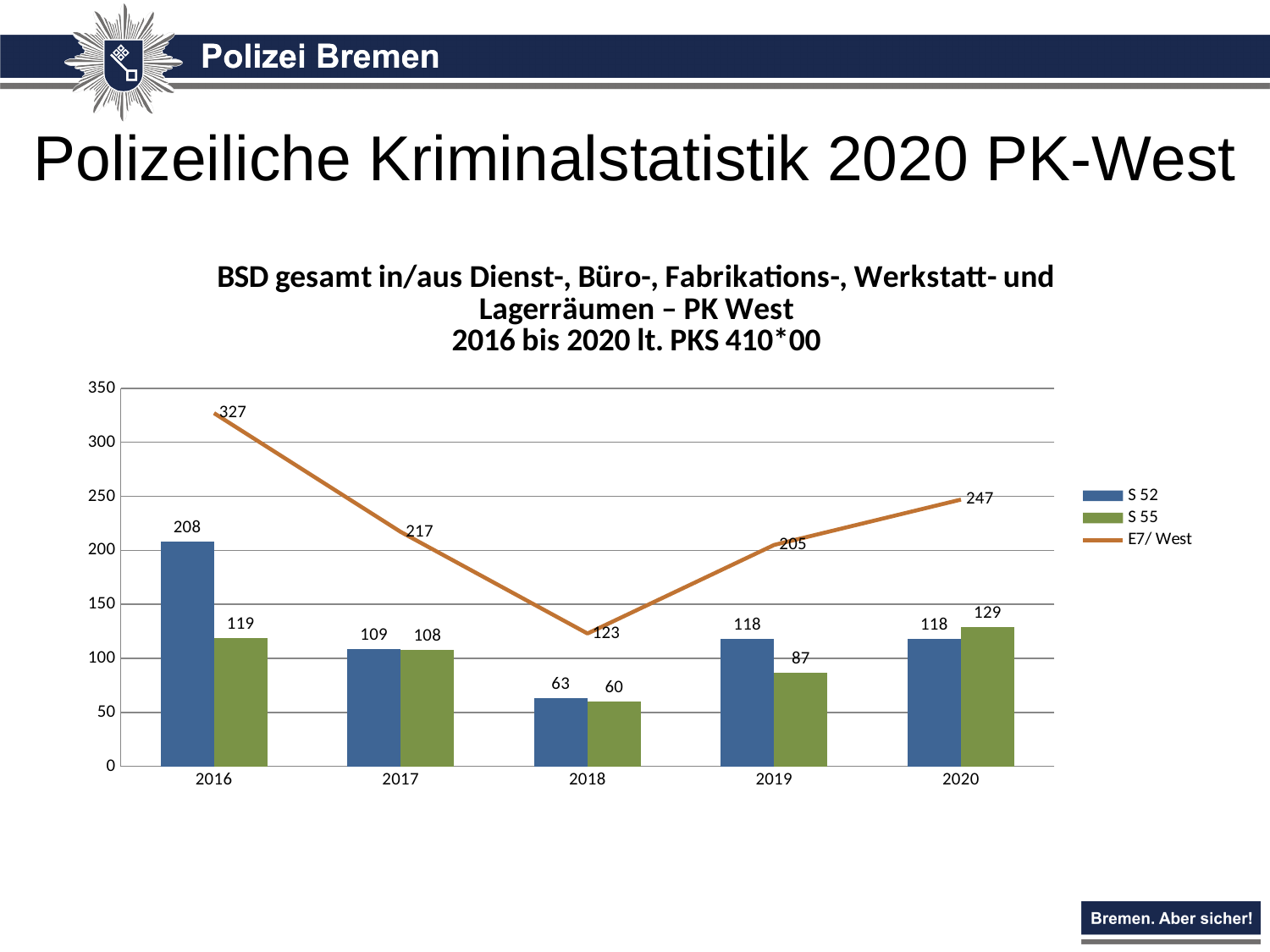
In which year is the S 55 value lowest? 2018 What kind of chart is this? Combined bar and line chart What is the value for S 52 in 2016? 208 How many series does the legend list? 3 Does the E7/ West line rise or fall from 2018 to 2020? Rise Which is larger in 2019, S 52 or S 55? S 52 What is the value for E7/ West in 2018? 123 In which year is the E7/ West line highest? 2016 What is the value for S 55 in 2020? 129 How many years are shown on the x axis? 5 What colour are the S 55 bars? Green What is the difference between the E7/ West values for 2016 and 2017? 110